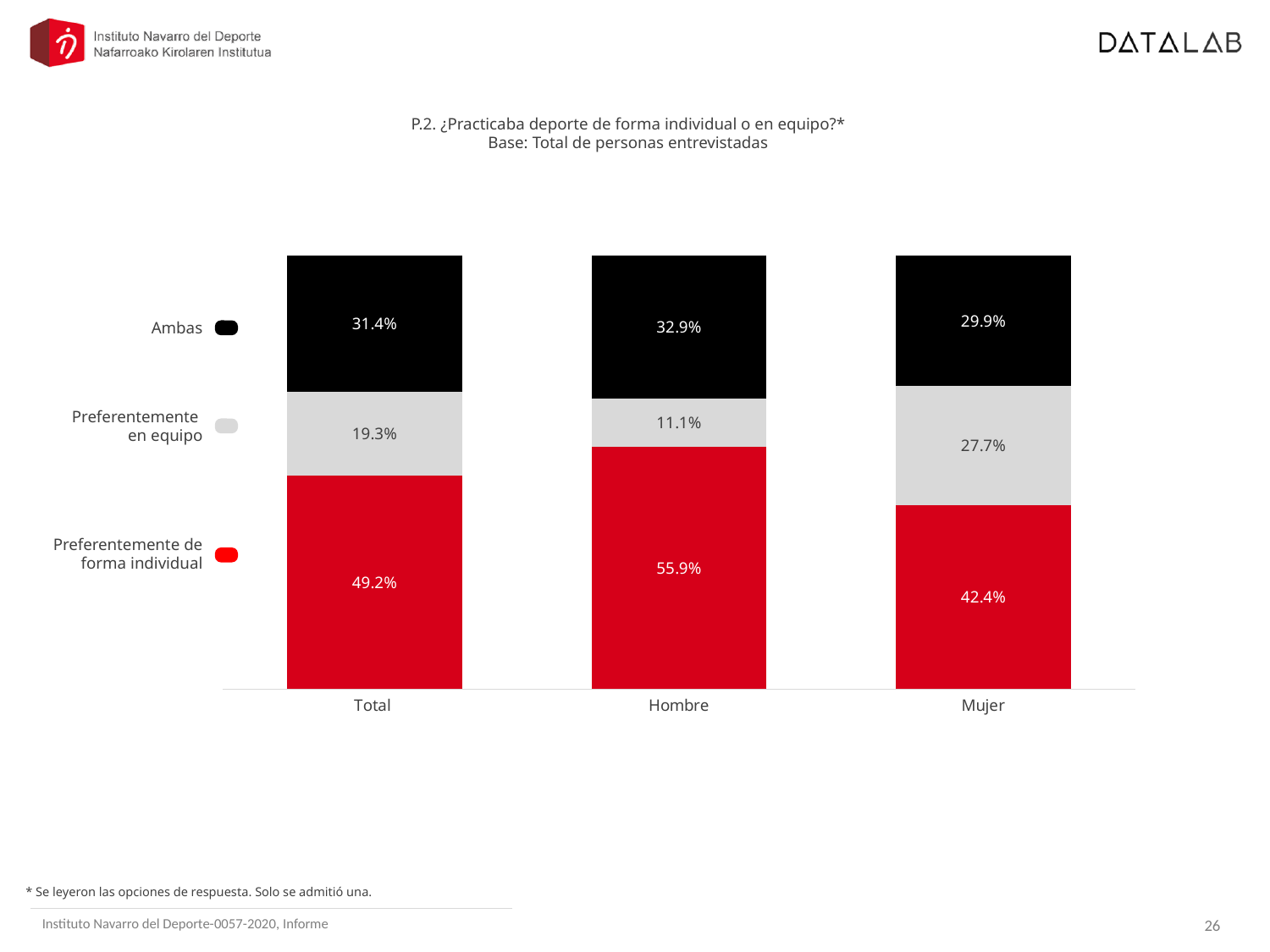
Which category has the highest value for 'Preferentemente de forma individual'? Hombre What is the value for 'Ambas' in the Total category? 31.4% Which colour represents 'Preferentemente de forma individual' in the chart? Red Which category has the lowest value for 'Preferentemente en equipo'? Hombre What is the difference between the 'Preferentemente en equipo' values for Mujer and Hombre? 16.6 percentage points What is the difference between the 'Preferentemente de forma individual' values for Hombre and Mujer? 13.5 percentage points How many categories are shown on the x axis? 3 What kind of chart is shown on the slide? Stacked bar chart What is the value for 'Preferentemente en equipo' in the Mujer category? 27.7% Which is larger: the 'Ambas' value for Hombre or for Mujer? Hombre What percentage of Hombre respondents answered 'Preferentemente de forma individual'? 55.9% How many series does the legend list? 3